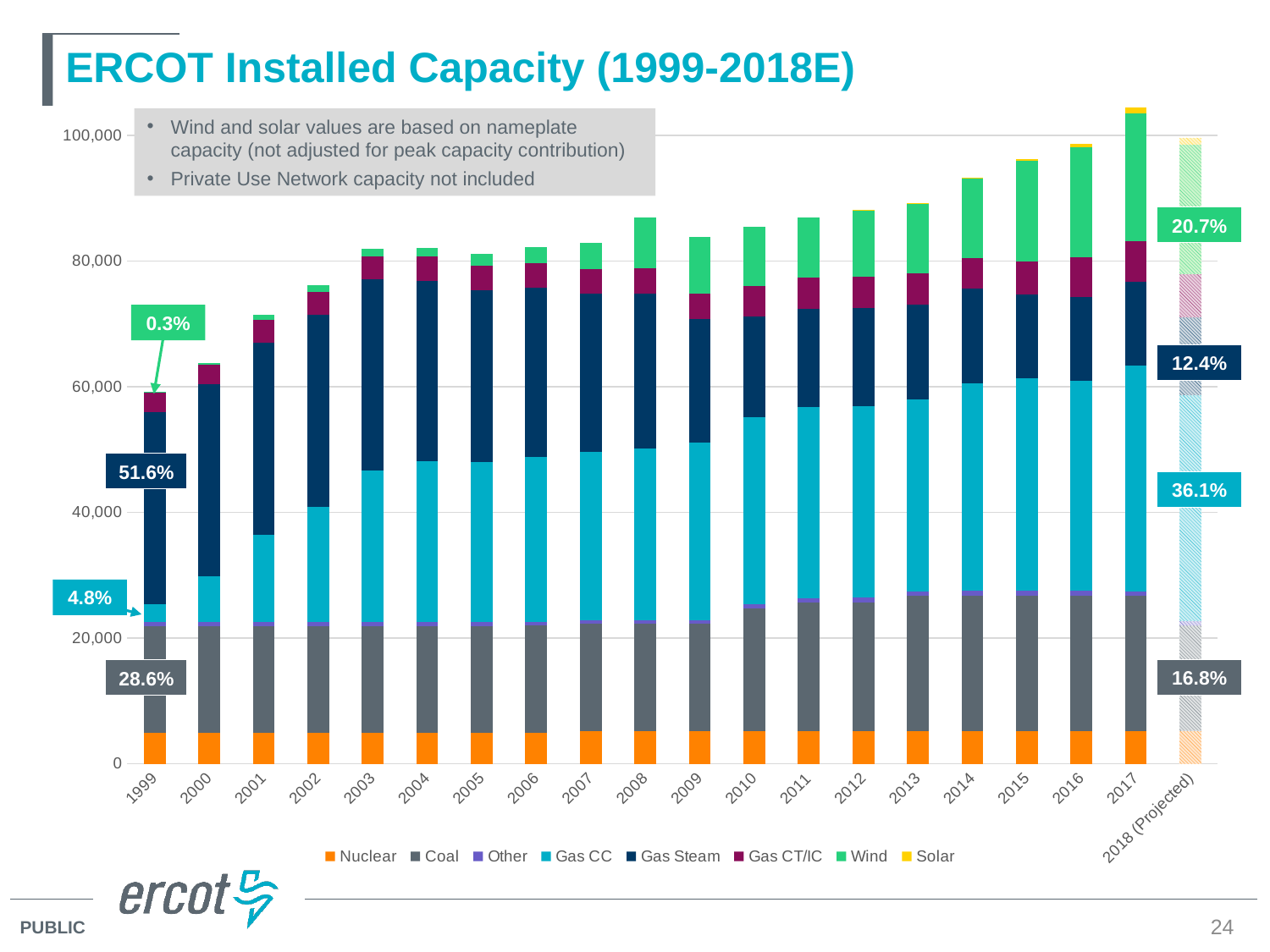
Which is larger: the Gas CC share in 1999 or the Gas CC share in 2017? 2017 Does total installed capacity generally rise or fall from 1999 to 2017? Rise What kind of chart is shown on the slide? Stacked bar chart What share of installed capacity did Gas Steam represent in 1999? 51.6% What share of installed capacity did Coal represent in 1999? 28.6% Is the total installed capacity for 2017 greater or less than 100,000? greater How many series does the legend list? 8 How many years (bars) are plotted on the x axis? 20 What is the title of the chart? ERCOT Installed Capacity (1999-2018E)